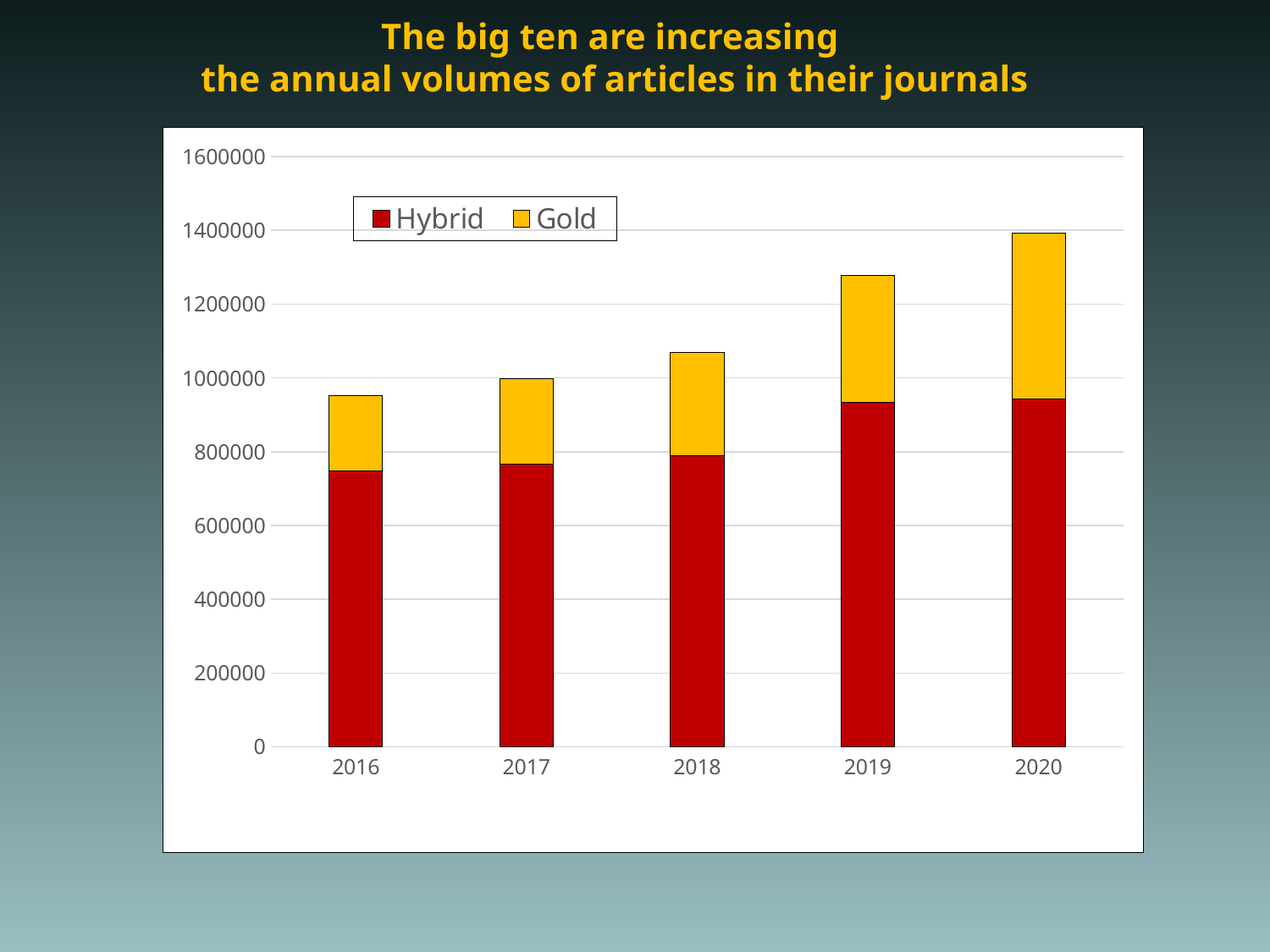
Which year has the shortest stacked bar? 2016 Is the total bar height for 2019 greater or less than 1200000? greater Which is larger, the Gold segment for 2020 or the Gold segment for 2016? 2020 What colour represents the Hybrid series in the chart? red What kind of chart is shown on the slide? bar chart Do the total bar heights rise or fall from 2016 to 2020? rise Is the total bar height for 2016 greater or less than 1000000? less Is the Hybrid value for 2020 greater or less than 1000000? less How many series does the legend list? 2 Which year has the tallest stacked bar? 2020 How many years are shown on the x axis of the chart? 5